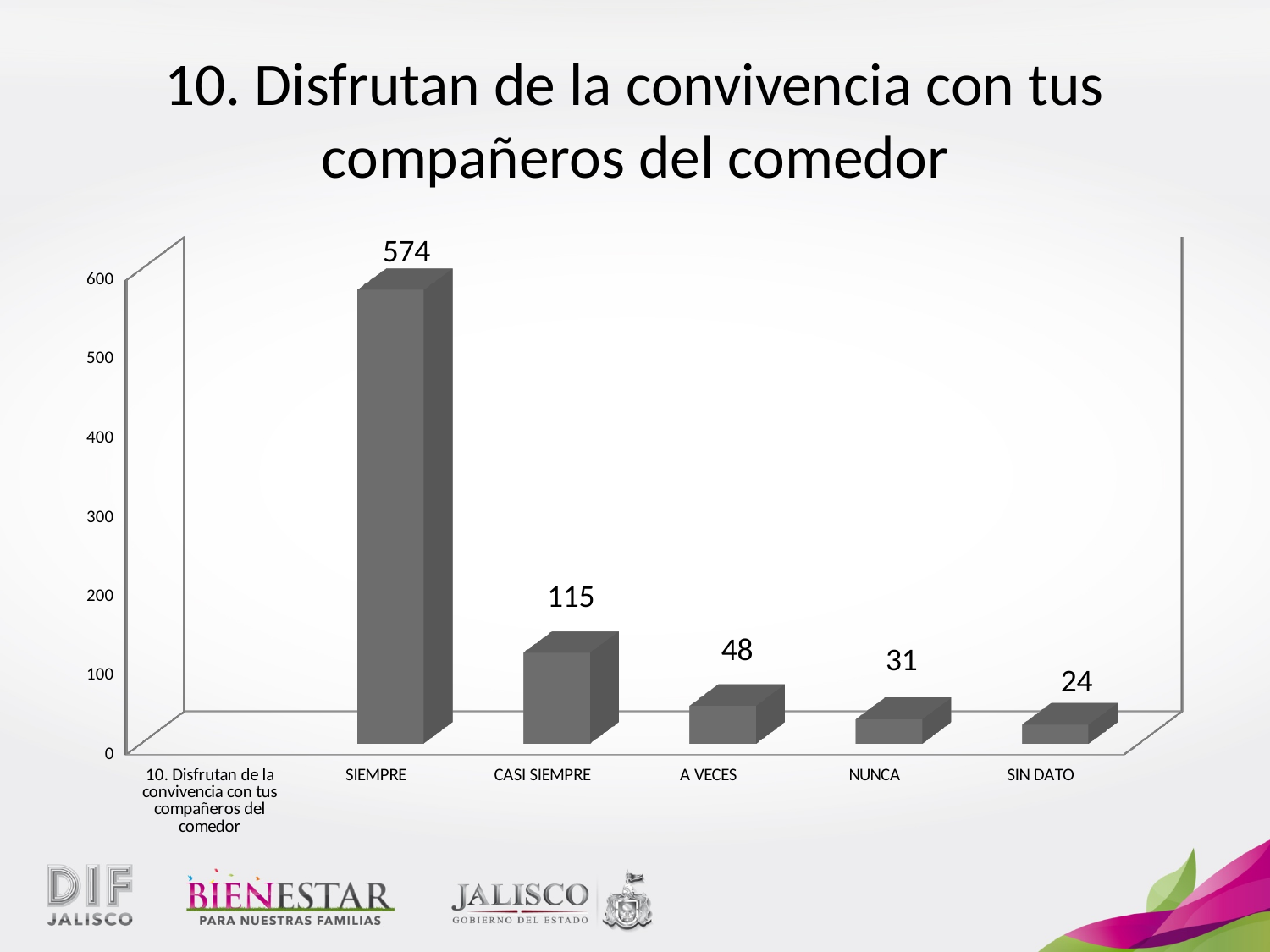
What is the value for SIN DATO? 24 Which category has the highest value? SIEMPRE What is the value for NUNCA? 31 What is the value for A VECES? 48 What is the value for CASI SIEMPRE? 115 Is the value for CASI SIEMPRE greater or less than 200? less Which category has the lowest value? SIN DATO What is the value for SIEMPRE? 574 What is the difference between the values for SIEMPRE and CASI SIEMPRE? 459 What kind of chart is shown on the slide? bar chart Which is larger, the value for A VECES or the value for NUNCA? A VECES How many bars are plotted in the chart? 5